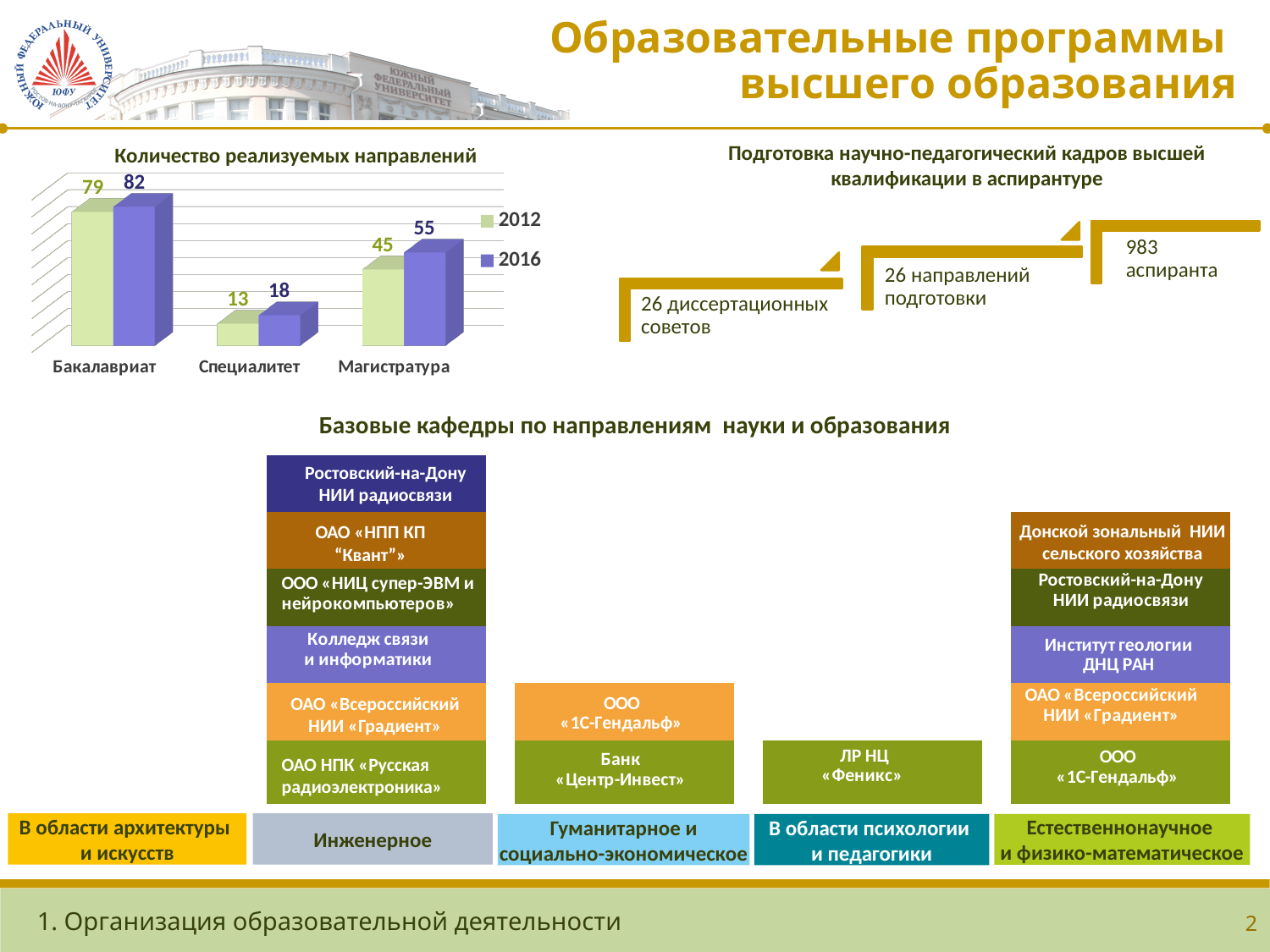
In the chart 'Количество реализуемых направлений', what is the difference between the 2016 and 2012 values for Магистратура? 10 In the chart 'Количество реализуемых направлений', which category has the highest value in 2012? Бакалавриат How many categories are shown in the chart 'Количество реализуемых направлений'? 3 What kind of chart is 'Количество реализуемых направлений'? Bar chart How many series does the legend of the chart 'Количество реализуемых направлений' list? 2 In the chart 'Количество реализуемых направлений', what is the value for Бакалавриат in 2016? 82 In the chart 'Количество реализуемых направлений', what is the value for Магистратура in 2016? 55 In the chart 'Количество реализуемых направлений', what is the difference between the 2016 and 2012 values for Специалитет? 5 In the chart 'Количество реализуемых направлений', which is larger: the 2012 value for Бакалавриат or the 2016 value for Магистратура? 2012 value for Бакалавриат In the chart 'Количество реализуемых направлений', which category has the lowest value in 2016? Специалитет In the chart 'Количество реализуемых направлений', which series is shown in purple? 2016 In the chart 'Количество реализуемых направлений', what is the value for Специалитет in 2012? 13